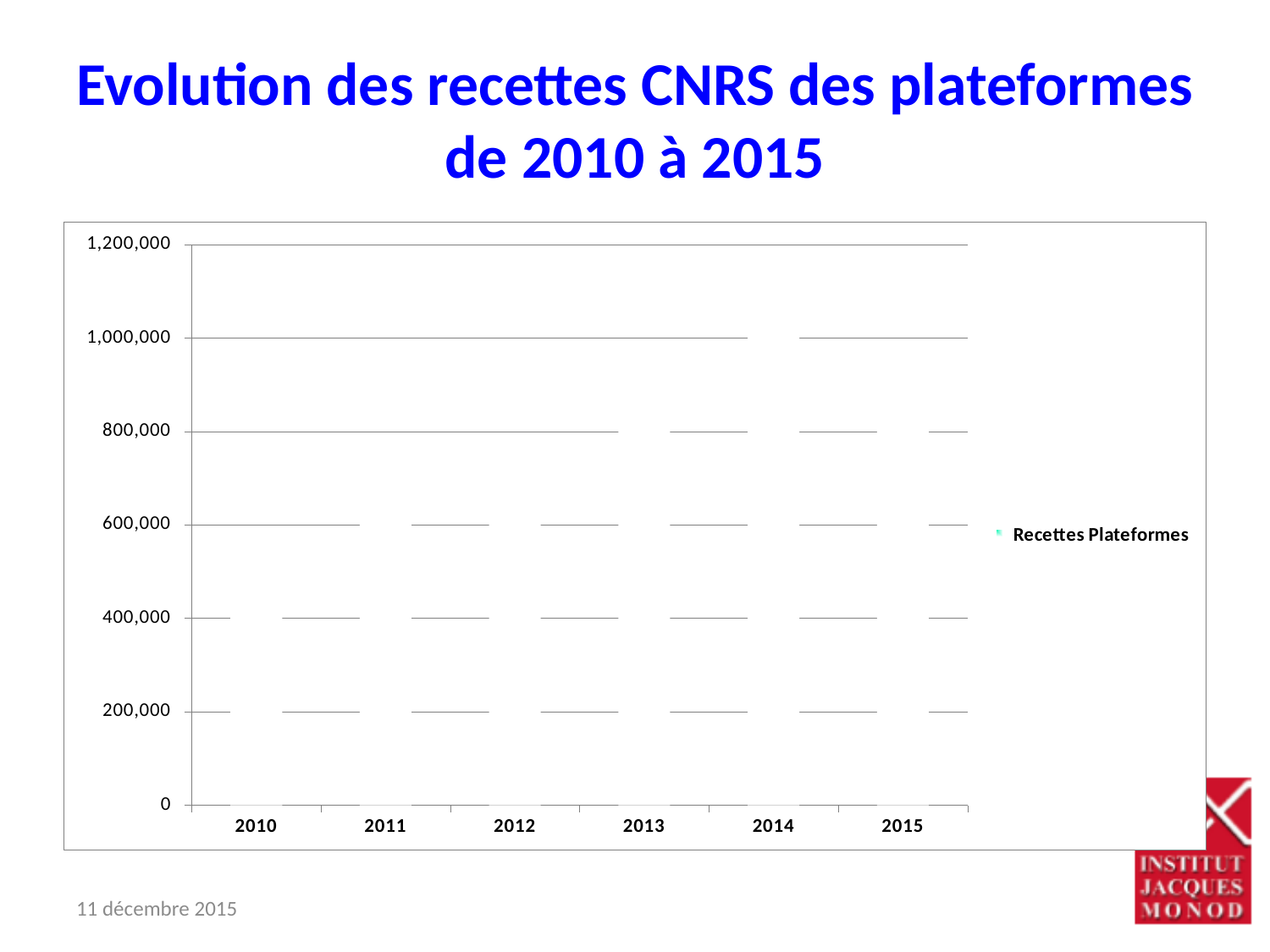
Is the value for 2010 greater or less than 600,000? less How many years are shown on the x axis of the chart? 6 Do the values for Recettes Plateformes rise or fall from 2010 to 2015? rise How many series does the chart legend list? 1 Is the value for 2013 greater or less than 600,000? greater What is the name of the series shown in the chart legend? Recettes Plateformes Is the value for 2015 greater or less than 1,000,000? less What kind of chart is shown on the slide? bar chart What is the highest value labelled on the vertical axis of the chart? 1,200,000 Which year has the highest value for Recettes Plateformes? 2014 What is the first year shown on the x axis of the chart? 2010 Which year has the lowest value for Recettes Plateformes? 2010